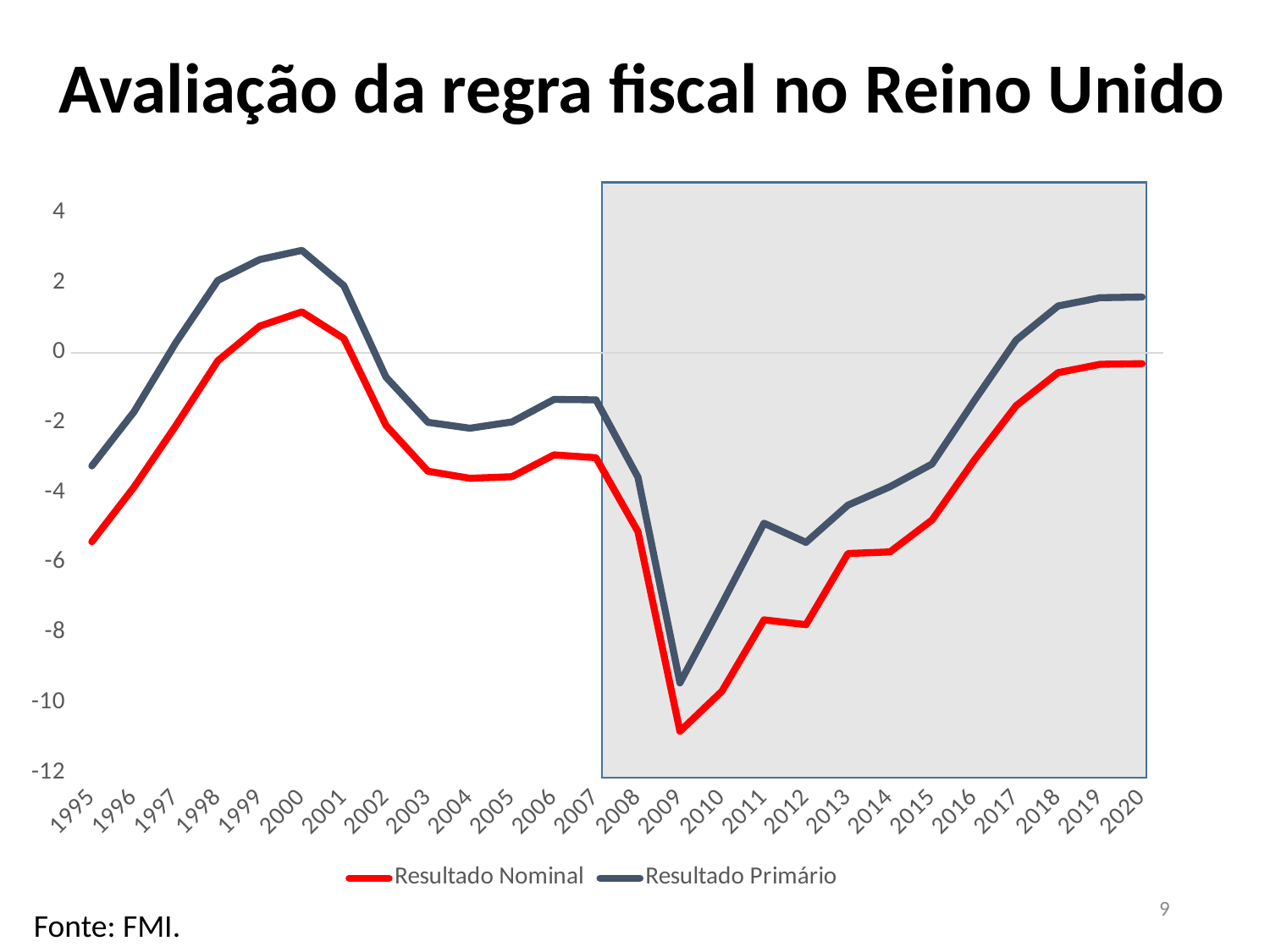
Do the values of Resultado Nominal rise or fall from 2009 to 2020? rise How many years are shown on the x axis? 26 Is the value for Resultado Primário in 2000 greater or less than 2? greater In which year does Resultado Primário reach its highest value? 2000 How many series does the legend list? 2 Is the value for Resultado Nominal in 2009 greater or less than -10? less Is the value for Resultado Nominal in 1995 greater or less than -4? less Which colour is used for the Resultado Nominal line? red In which year does Resultado Nominal reach its lowest value? 2009 In 2009, which series has the higher value, Resultado Nominal or Resultado Primário? Resultado Primário What kind of chart is shown on the slide? line chart